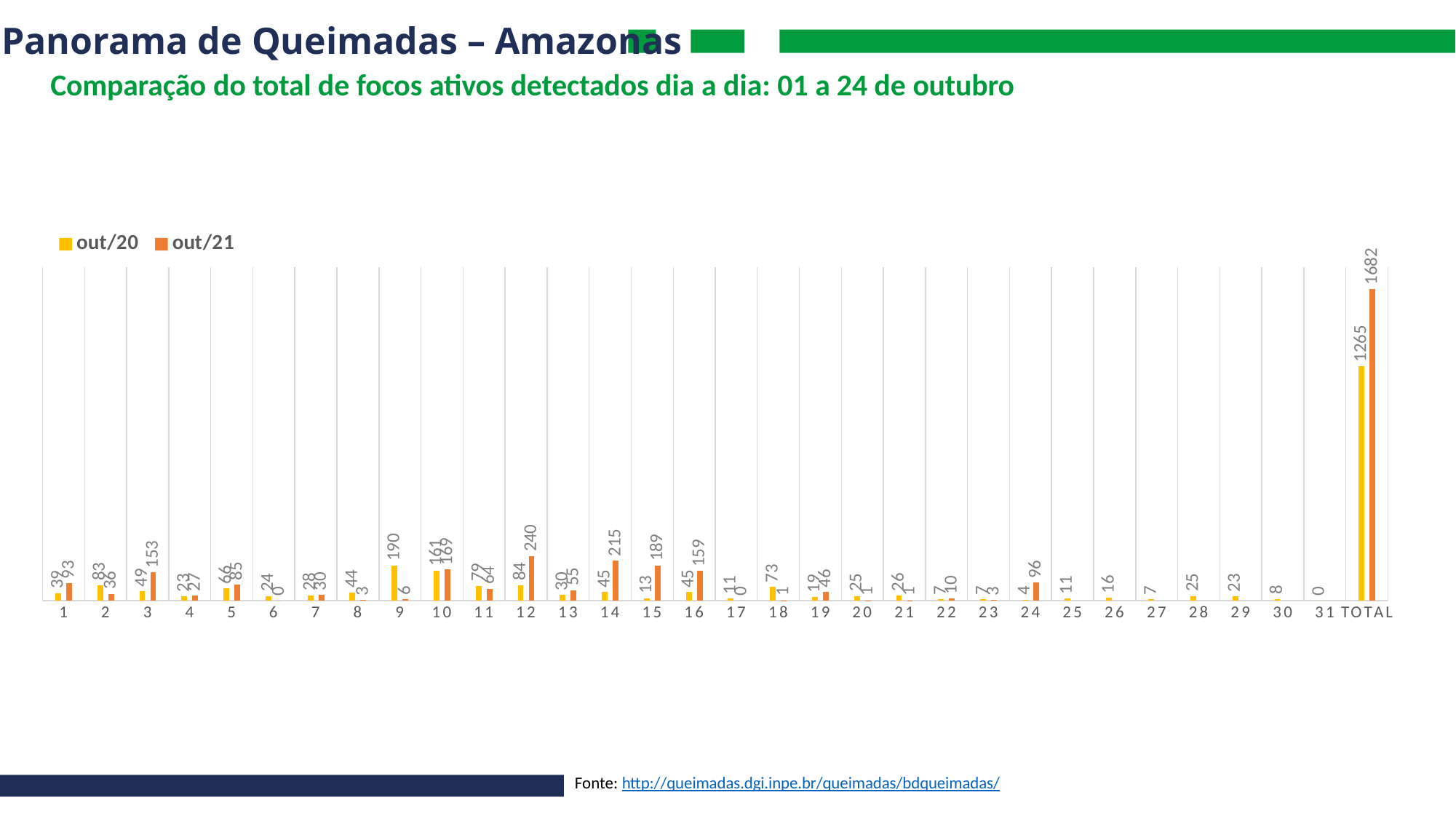
Excluding the TOTAL bar, which day has the highest out/20 value? 9 What is the difference between the out/21 and out/20 TOTAL values? 417 What kind of chart is shown on the slide? Bar chart Excluding the TOTAL bar, which day has the highest out/21 value? 12 What is the out/20 value for day 9? 190 What is the value of the TOTAL bar for the out/21 series? 1682 What is the out/21 value for day 12? 240 How many series does the legend list? 2 What is the out/21 value for day 15? 189 What is the value of the TOTAL bar for the out/20 series? 1265 On day 3, which series has the larger value, out/20 or out/21? out/21 What is the difference between the out/21 and out/20 values on day 14? 170